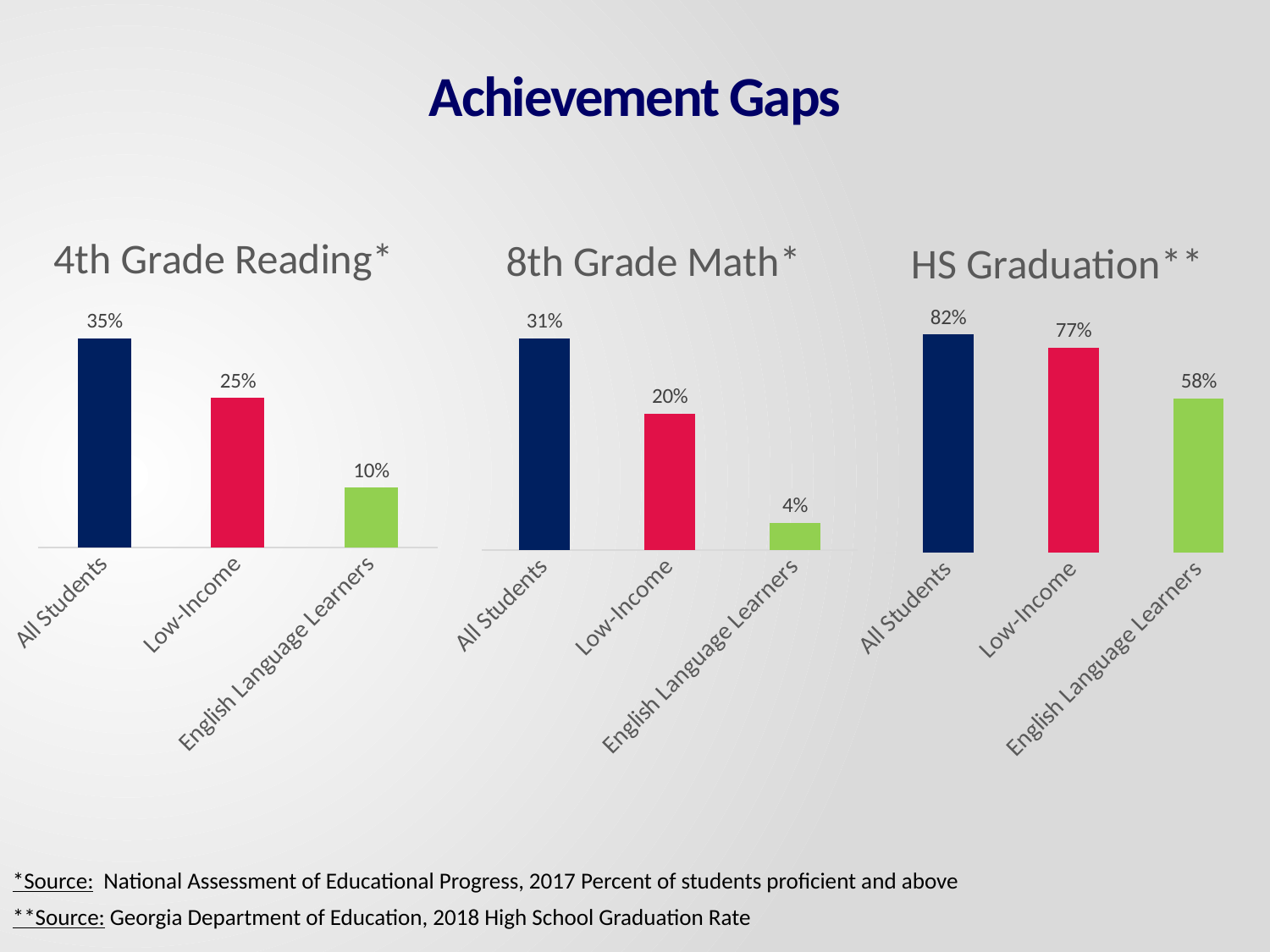
In the 4th Grade Reading chart, what is the difference between All Students and English Language Learners? 25% In the HS Graduation chart, what is the difference between All Students and Low-Income? 5% In the 8th Grade Math chart, do the values rise or fall from left to right? Fall In the 4th Grade Reading chart, what is the value for Low-Income? 25% In the 8th Grade Math chart, which is larger, the value for Low-Income or the value for English Language Learners? Low-Income In the HS Graduation chart, what is the value for All Students? 82% How many charts are shown on the slide? 3 In the 8th Grade Math chart, which category has the highest value? All Students In the HS Graduation chart, which category has the lowest value? English Language Learners How many categories does the 4th Grade Reading chart show? 3 In the 8th Grade Math chart, what is the value for English Language Learners? 4% What kind of chart is the HS Graduation chart? Bar chart